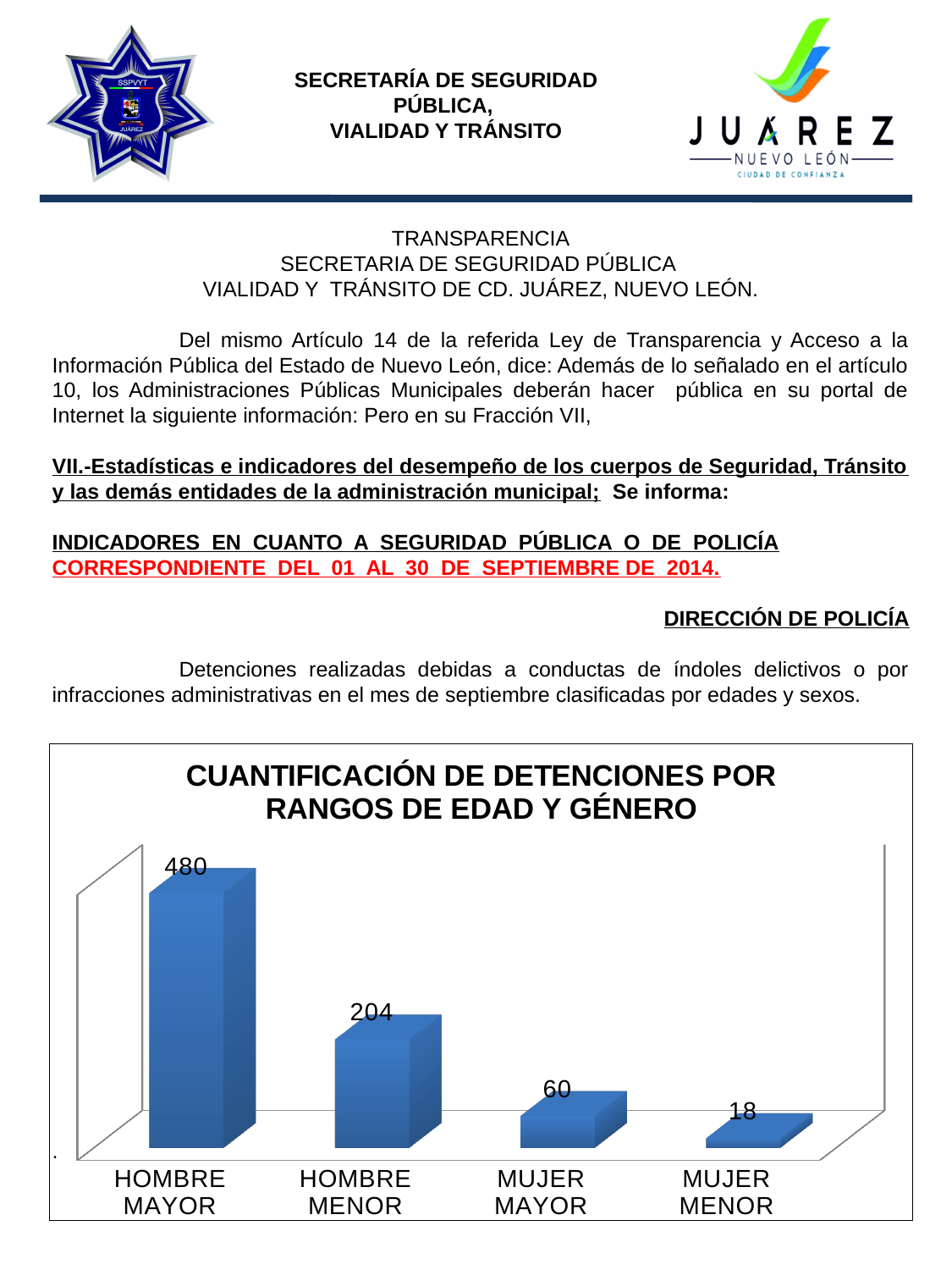
Which category has the highest value? HOMBRE MAYOR What kind of chart is shown on the slide? Bar chart What is the value for HOMBRE MENOR? 204 What is the difference between the values for MUJER MAYOR and MUJER MENOR? 42 What is the value for MUJER MAYOR? 60 What is the title of the chart? CUANTIFICACIÓN DE DETENCIONES POR RANGOS DE EDAD Y GÉNERO What is the difference between the values for HOMBRE MAYOR and HOMBRE MENOR? 276 Which category has the lowest value? MUJER MENOR Which is larger, the value for HOMBRE MENOR or the value for MUJER MAYOR? HOMBRE MENOR What is the value for HOMBRE MAYOR? 480 How many categories are shown in the chart? 4 What is the value for MUJER MENOR? 18